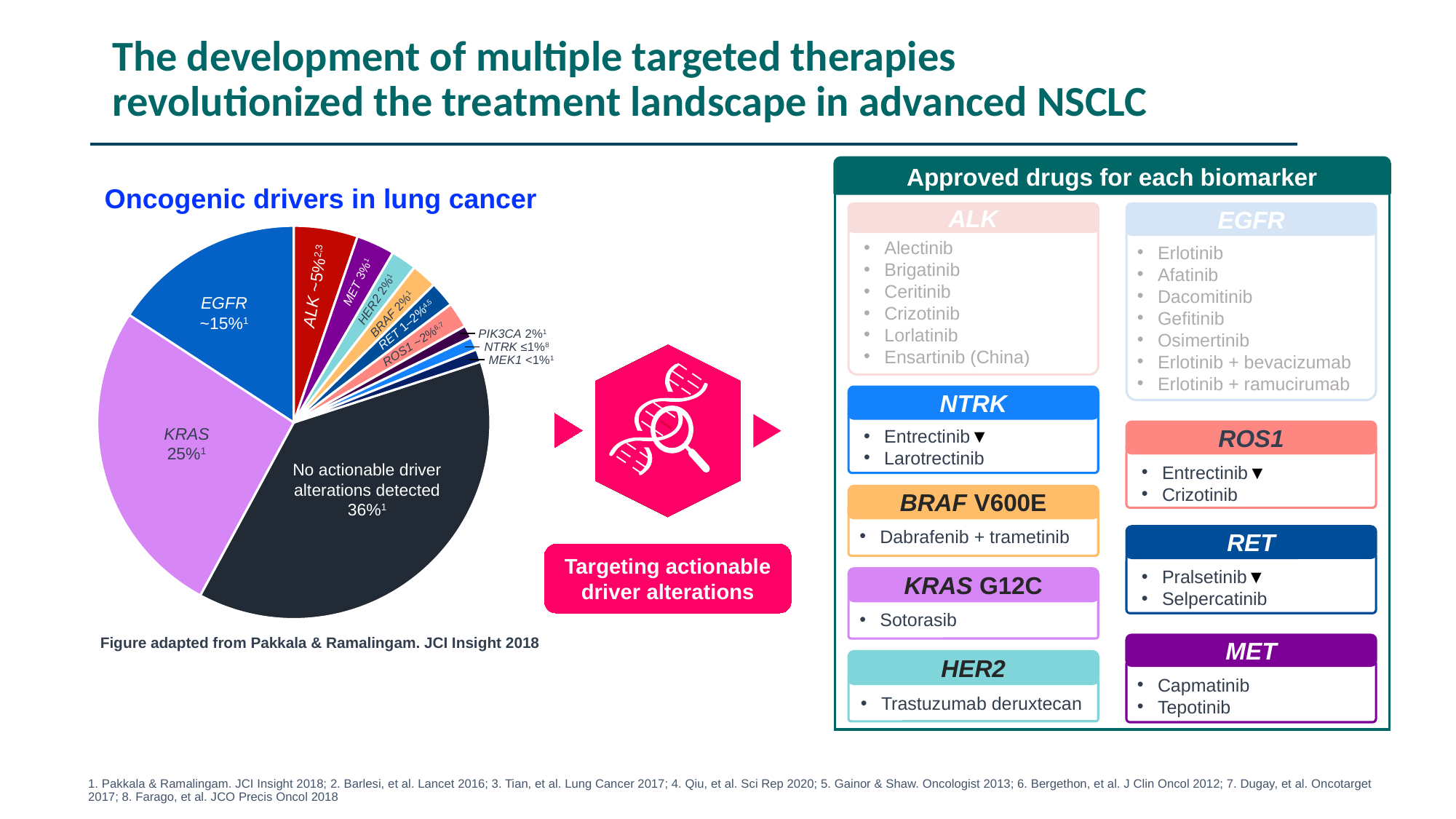
In the 'Oncogenic drivers in lung cancer' pie chart, what percentage is shown for 'No actionable driver alterations detected'? 36% What type of chart is shown under the heading 'Oncogenic drivers in lung cancer'? pie chart In the 'Oncogenic drivers in lung cancer' pie chart, what is the difference in percentage points between 'No actionable driver alterations detected' and KRAS? 11 percentage points What is the title of the pie chart on the slide? Oncogenic drivers in lung cancer In the 'Oncogenic drivers in lung cancer' pie chart, what percentage is shown for KRAS? 25% In the 'Oncogenic drivers in lung cancer' pie chart, which slice is the largest? No actionable driver alterations detected In the 'Oncogenic drivers in lung cancer' pie chart, which is larger, the KRAS slice or the EGFR slice? KRAS In the 'Oncogenic drivers in lung cancer' pie chart, what percentage is shown for MET? 3% In the 'Oncogenic drivers in lung cancer' pie chart, what share of the pie does KRAS represent? 25% In the 'Oncogenic drivers in lung cancer' pie chart, what percentage is shown for PIK3CA? 2% In the 'Oncogenic drivers in lung cancer' pie chart, what percentage is shown for HER2? 2% How many slices does the 'Oncogenic drivers in lung cancer' pie chart have? 12